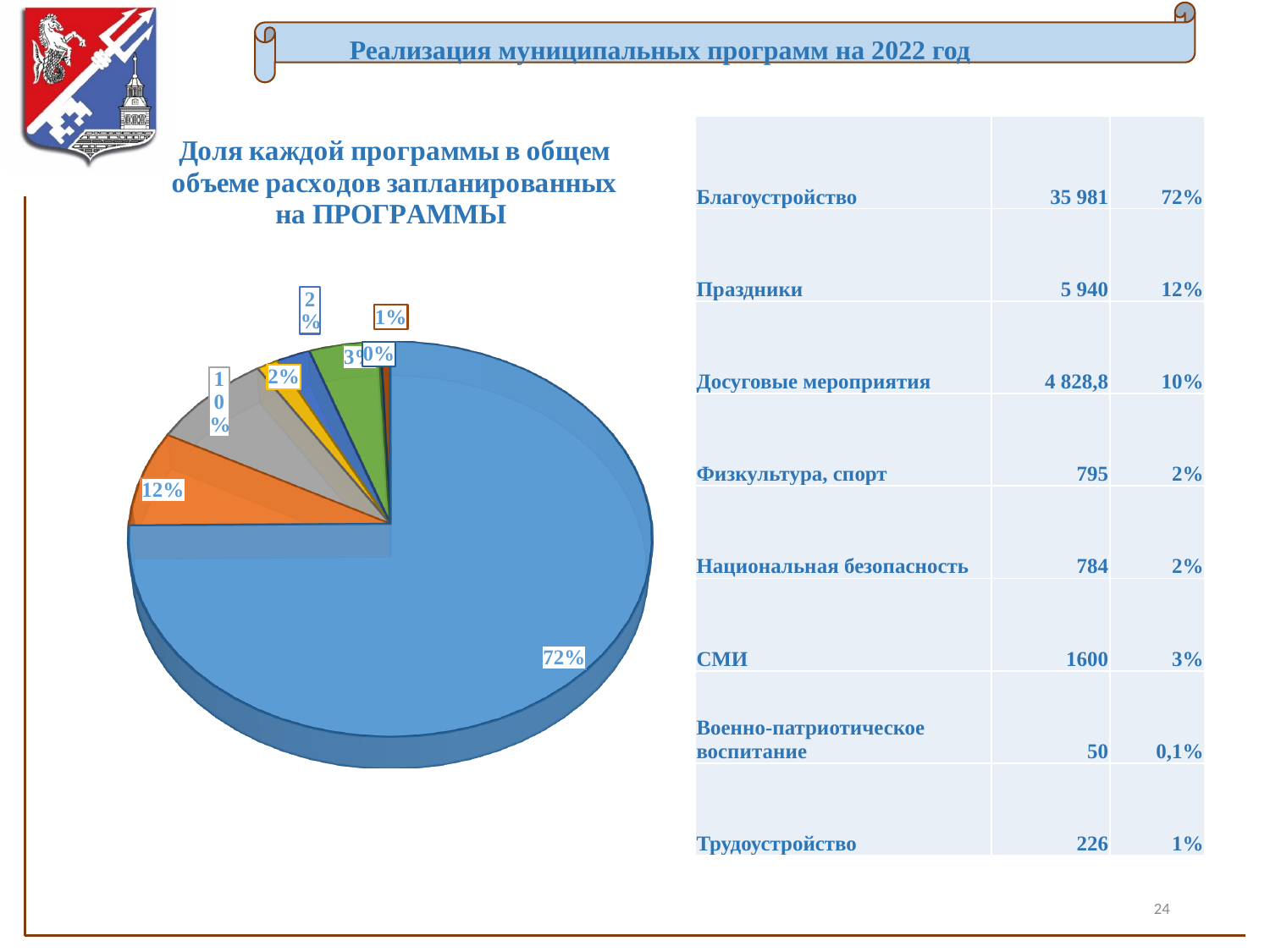
Which is larger on the pie chart, the 12% slice or the 10% slice? 12% According to the slide, what share of the pie does Праздники have? 12% What colour is the largest slice of the pie chart? blue What is the difference in percentage points between the 72% slice and the 12% slice? 60 What is the title of the pie chart? Доля каждой программы в общем объеме расходов запланированных на ПРОГРАММЫ What kind of chart is shown on the slide? pie chart What is the percentage shown on the largest slice of the pie chart? 72% How many slices does the pie chart have? 8 What is the difference in percentage points between the 12% slice and the 10% slice? 2 According to the slide, which program corresponds to the 72% slice of the pie chart? Благоустройство What is the smallest percentage label shown on the pie chart? 0% Is the largest slice of the pie chart greater or less than 50%? greater